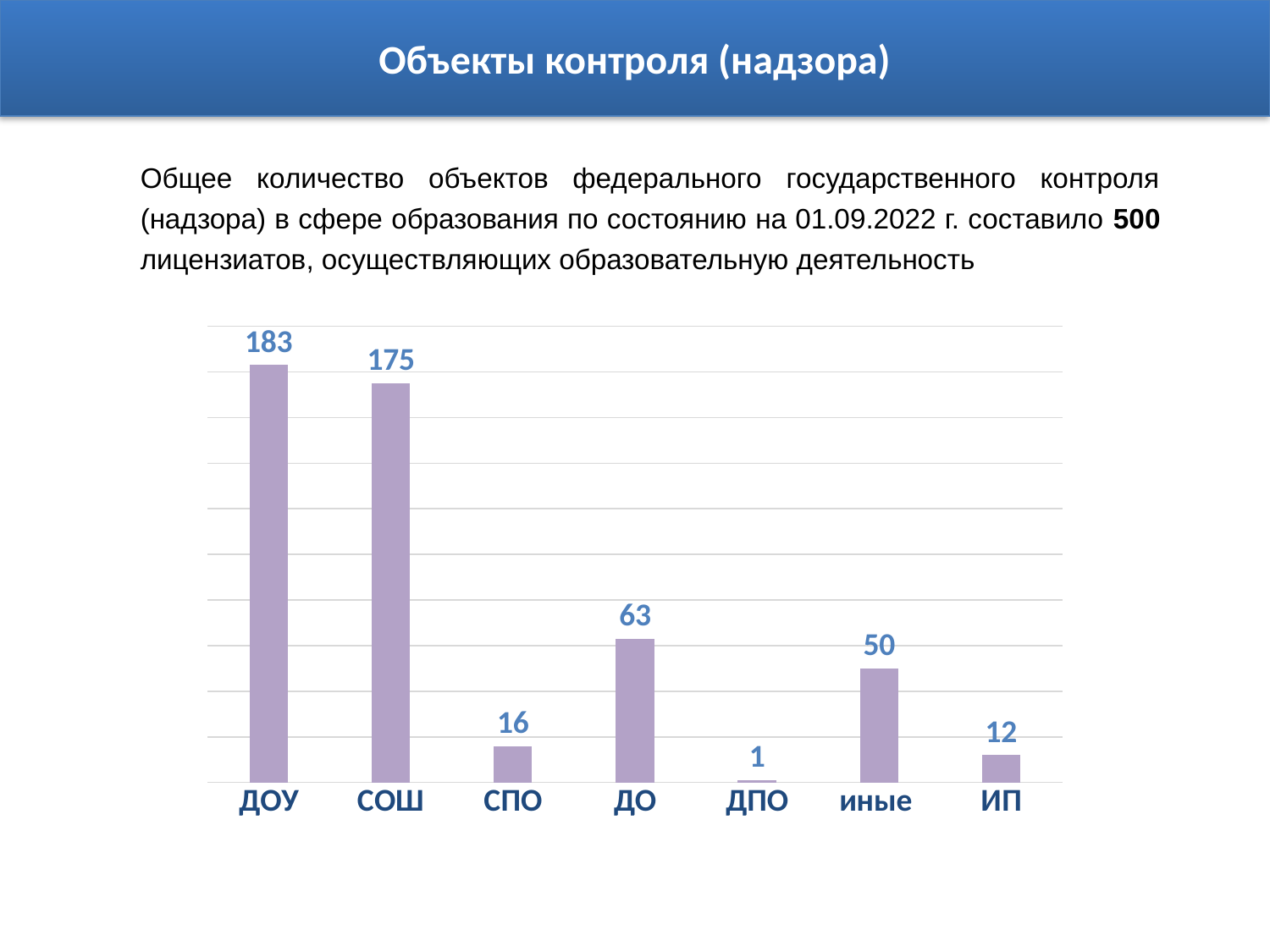
What is the difference between the values for ДОУ and СОШ? 8 What is the value for ДО? 63 What is the value for ДПО? 1 Which category has the highest value? ДОУ How many categories are shown on the x axis? 7 Which category has the lowest value? ДПО What is the difference between the values for ДО and иные? 13 Which is larger, the value for СПО or the value for ИП? СПО What kind of chart is shown on the slide? bar chart What is the value for ДОУ? 183 What is the value for СОШ? 175 What is the value for иные? 50